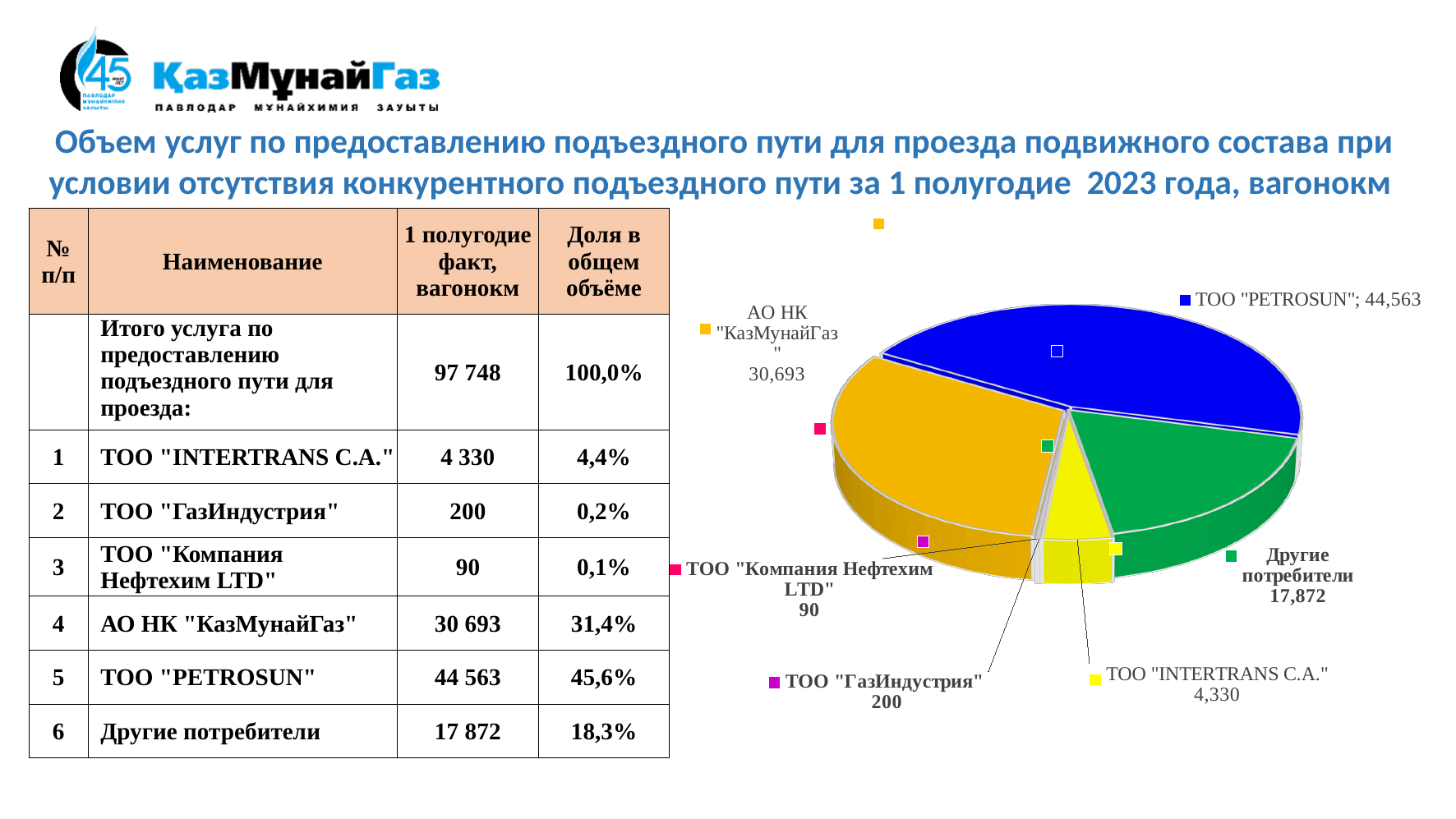
What is the value shown for ТОО "PETROSUN" in the pie chart? 44,563 What kind of chart is shown on the slide? pie chart Which is larger in the pie chart: Другие потребители or ТОО "INTERTRANS C.A."? Другие потребители What is the difference between the values for ТОО "PETROSUN" and АО НК "КазМунайГаз" in the pie chart? 13,870 What is the value shown for ТОО "Компания Нефтехим LTD" in the pie chart? 90 What is the value shown for АО НК "КазМунайГаз" in the pie chart? 30,693 What colour is the ТОО "PETROSUN" slice in the pie chart? blue How many slices does the pie chart have? 6 Which category has the largest slice in the pie chart? ТОО "PETROSUN" What is the value shown for ТОО "INTERTRANS C.A." in the pie chart? 4,330 Which category has the smallest slice in the pie chart? ТОО "Компания Нефтехим LTD" What is the value shown for Другие потребители in the pie chart? 17,872